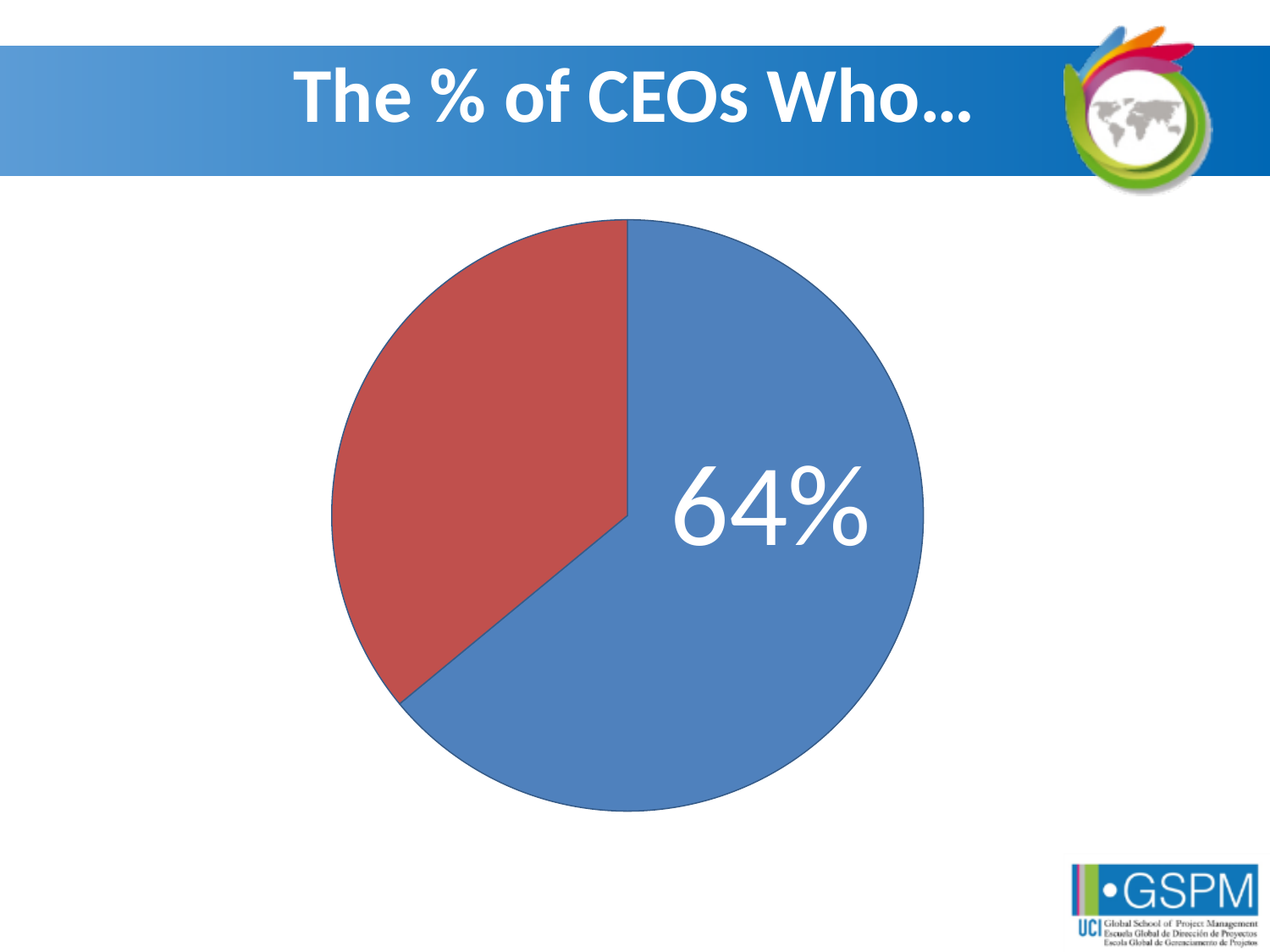
What share of the pie does the blue slice represent? 64% What is the title of the slide containing the pie chart? The % of CEOs Who… How many slices does the pie chart have? 2 Which slice of the pie chart is the smallest? the red slice Which slice of the pie chart is larger, the blue one or the red one? the blue one Which slice of the pie chart is the largest? the blue slice What percentage is printed on the blue slice of the pie chart? 64% What colour is the slice of the pie chart that carries the 64% label? blue What kind of chart is shown on the slide? pie chart